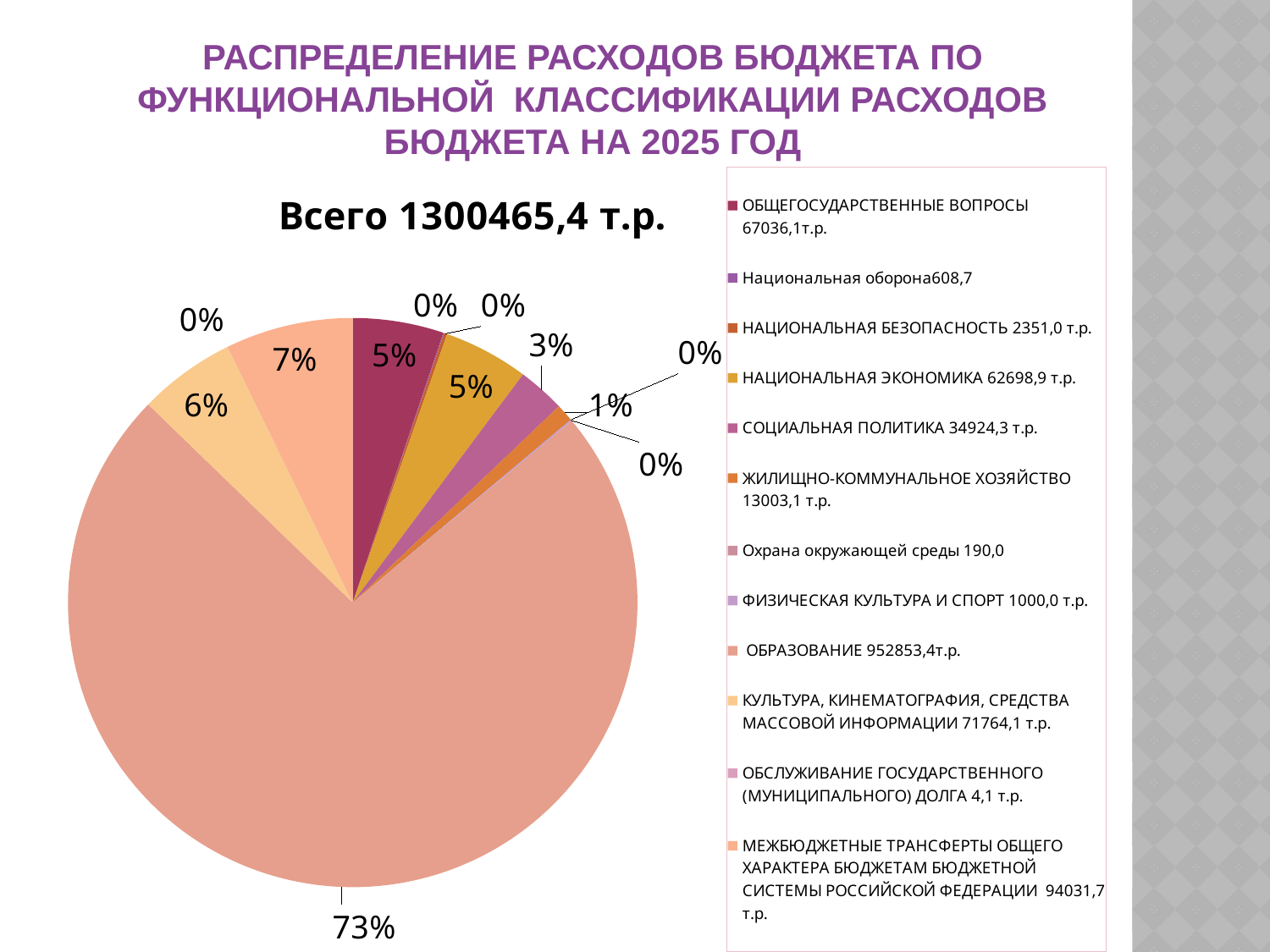
What value is given in the legend for ОБСЛУЖИВАНИЕ ГОСУДАРСТВЕННОГО (МУНИЦИПАЛЬНОГО) ДОЛГА? 4,1 т.р. What share of the pie does ОБРАЗОВАНИЕ take? 73% How many categories does the legend list? 12 Which is larger: the slice for ОБРАЗОВАНИЕ or the slice for КУЛЬТУРА, КИНЕМАТОГРАФИЯ, СРЕДСТВА МАССОВОЙ ИНФОРМАЦИИ? ОБРАЗОВАНИЕ What share of the pie does ЖИЛИЩНО-КОММУНАЛЬНОЕ ХОЗЯЙСТВО take? 1% Which category has the largest slice of the pie? ОБРАЗОВАНИЕ What share of the pie does МЕЖБЮДЖЕТНЫЕ ТРАНСФЕРТЫ ОБЩЕГО ХАРАКТЕРА take? 7% What total amount is stated in the chart title? Всего 1300465,4 т.р. What kind of chart is shown on the slide? pie chart By how much does the legend value for МЕЖБЮДЖЕТНЫЕ ТРАНСФЕРТЫ (94031,7) exceed the value for КУЛЬТУРА, КИНЕМАТОГРАФИЯ, СРЕДСТВА МАССОВОЙ ИНФОРМАЦИИ (71764,1)? 22267,6 What value is given in the legend for Национальная оборона? 608,7